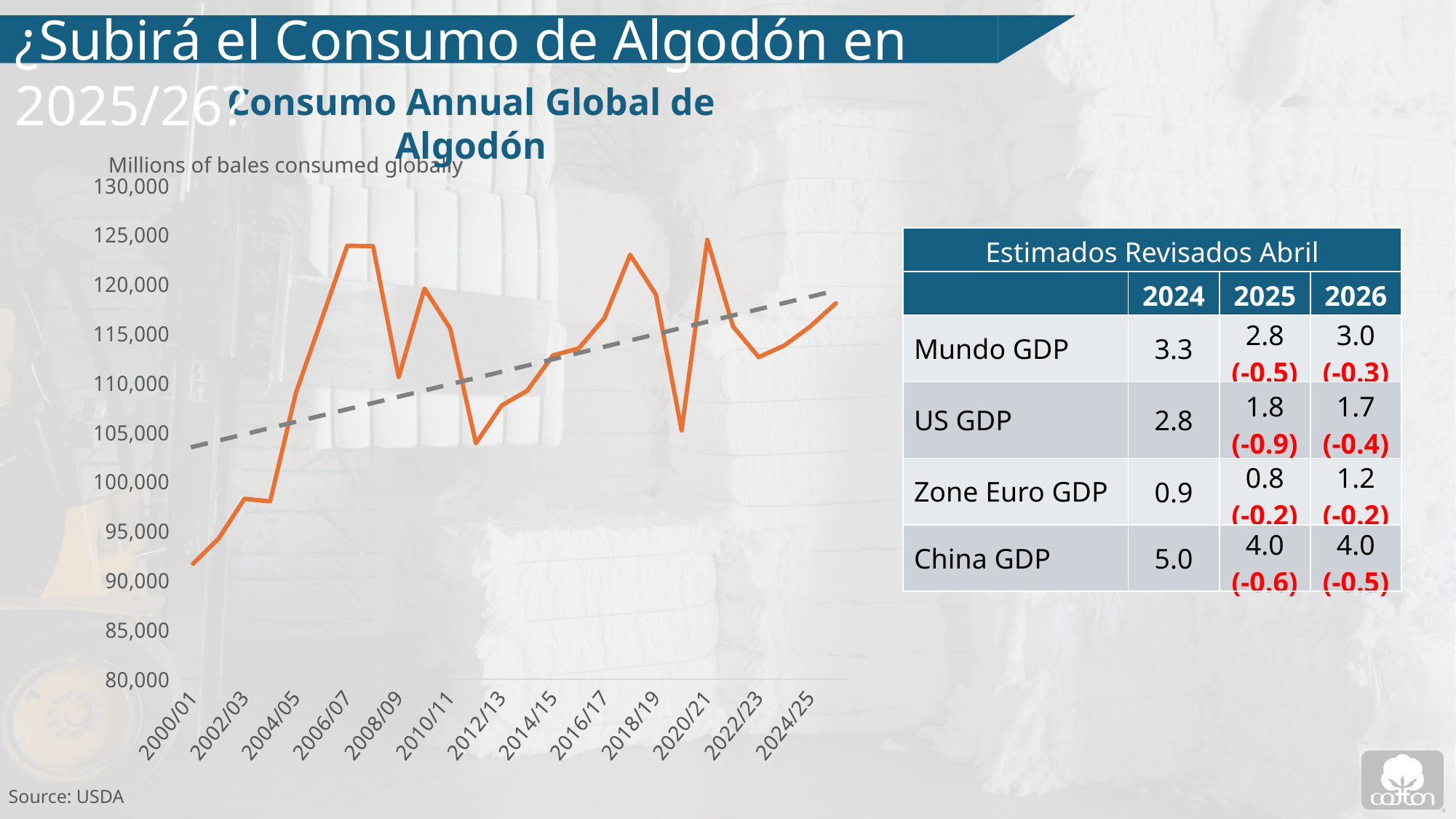
Is the value for 2006/07 greater or less than 120,000? greater Which season has the lowest consumption on the chart? 2000/01 Is the value for 2002/03 greater or less than 105,000? less Is the value for 2020/21 greater or less than 120,000? greater What kind of chart is shown on the slide? line chart Does the dashed trend line rise or fall from left to right? rise What is the title of the chart? Consumo Annual Global de Algodón How many season labels are shown on the x axis? 13 What unit does the chart's subtitle say the values are in? Millions of bales consumed globally Which is larger, the value for 2000/01 or the value for 2024/25? 2024/25